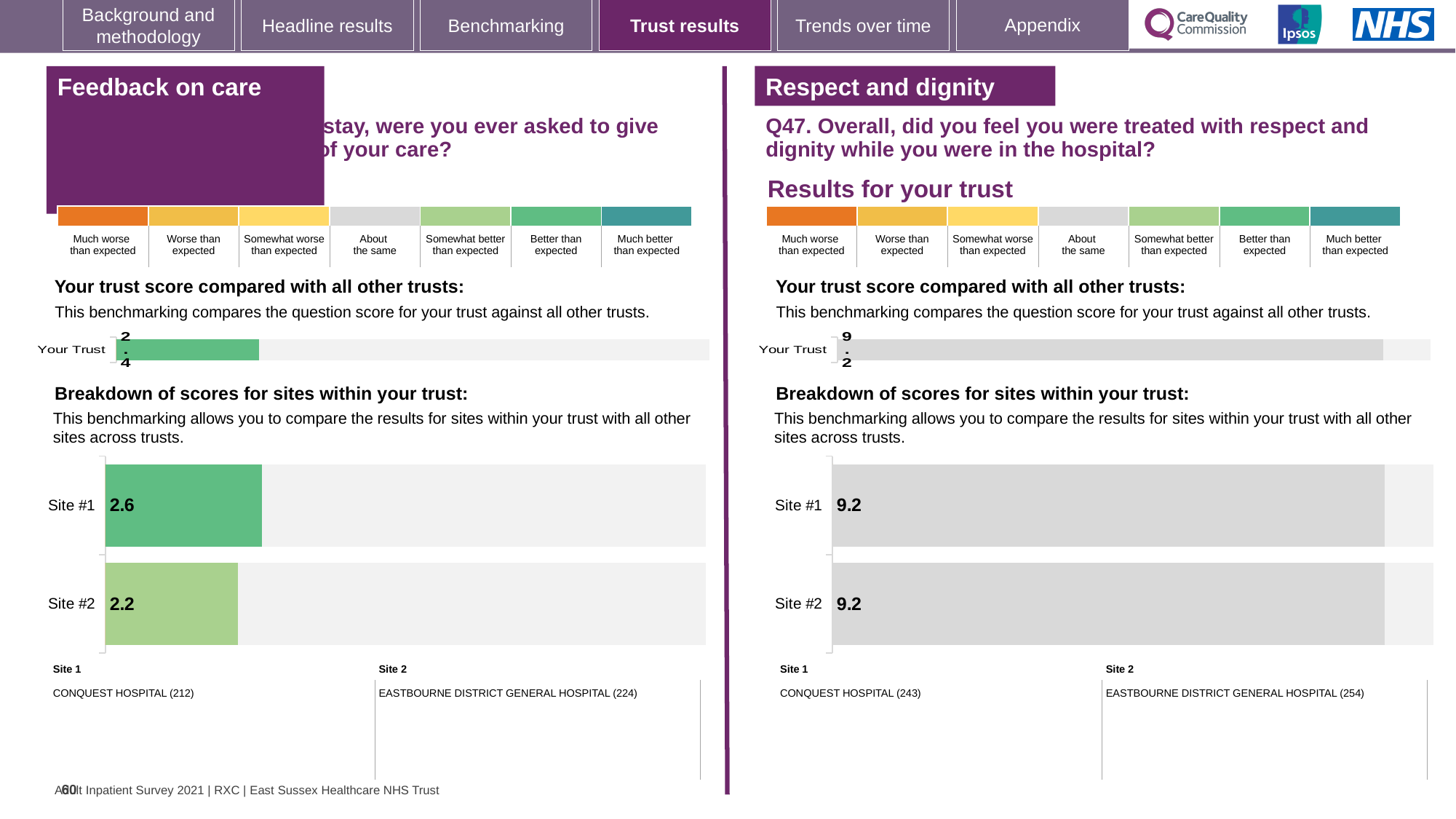
In the 'Feedback on care' site breakdown chart, what is the score for Site #2? 2.2 In the 'Respect and dignity' site breakdown chart, what is the difference between the Site #1 and Site #2 scores? 0 What type of chart is used for the site breakdown in the 'Feedback on care' section? Bar chart In the 'Feedback on care' site breakdown chart, what is the difference between the Site #1 and Site #2 scores? 0.4 In the 'Feedback on care' site breakdown chart, which site has the lowest score? Site #2 How many sites are shown in the 'Respect and dignity' site breakdown chart? 2 In the 'Feedback on care' site breakdown chart, what is the score for Site #1? 2.6 In the 'Feedback on care' site breakdown chart, is the Site #1 score larger or smaller than the Site #2 score? Larger In the 'Respect and dignity' site breakdown chart, what is the score for Site #1? 9.2 In the 'Respect and dignity' section, what is the 'Your Trust' score shown in the trust comparison bar? 9.2 In the 'Feedback on care' section, what is the 'Your Trust' score shown in the trust comparison bar? 2.4 In the 'Feedback on care' site breakdown chart, which site has the higher score? Site #1